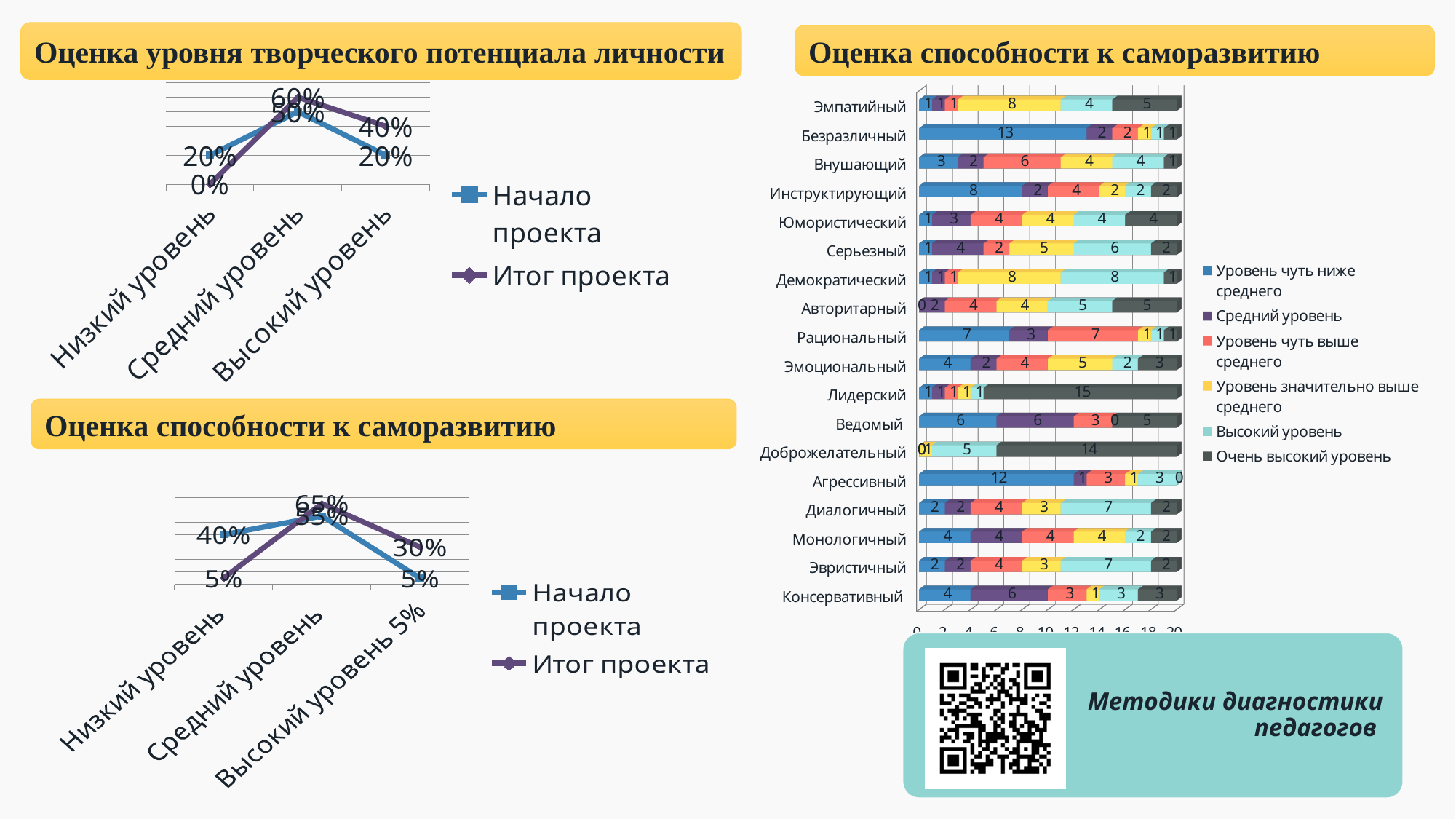
How many series does the legend list in the stacked bar chart on the right titled 'Оценка способности к саморазвитию'? 6 In the line chart at the bottom left titled 'Оценка способности к саморазвитию', what is the value of 'Итог проекта' for 'Средний уровень'? 65% In the line chart at the bottom left titled 'Оценка способности к саморазвитию', what is the value of 'Начало проекта' for 'Низкий уровень'? 40% In the stacked bar chart on the right titled 'Оценка способности к саморазвитию', what is the total of the stacked bar for 'Эмпатийный'? 20 What kind of chart is the one titled 'Оценка уровня творческого потенциала личности'? Line chart In the chart titled 'Оценка уровня творческого потенциала личности', what is the value of 'Начало проекта' for 'Низкий уровень'? 20% In the chart titled 'Оценка уровня творческого потенциала личности', what is the difference between 'Итог проекта' and 'Начало проекта' for 'Высокий уровень'? 20% In the line chart at the bottom left titled 'Оценка способности к саморазвитию', which category has the highest value for 'Итог проекта'? Средний уровень In the chart titled 'Оценка уровня творческого потенциала личности', what is the value of 'Итог проекта' for 'Средний уровень'? 60% In the stacked bar chart on the right titled 'Оценка способности к саморазвитию', what is the value of 'Очень высокий уровень' for 'Лидерский'? 15 How many series does the legend list in the chart titled 'Оценка уровня творческого потенциала личности'? 2 In the stacked bar chart on the right titled 'Оценка способности к саморазвитию', what is the value of 'Уровень чуть ниже среднего' for 'Безразличный'? 13